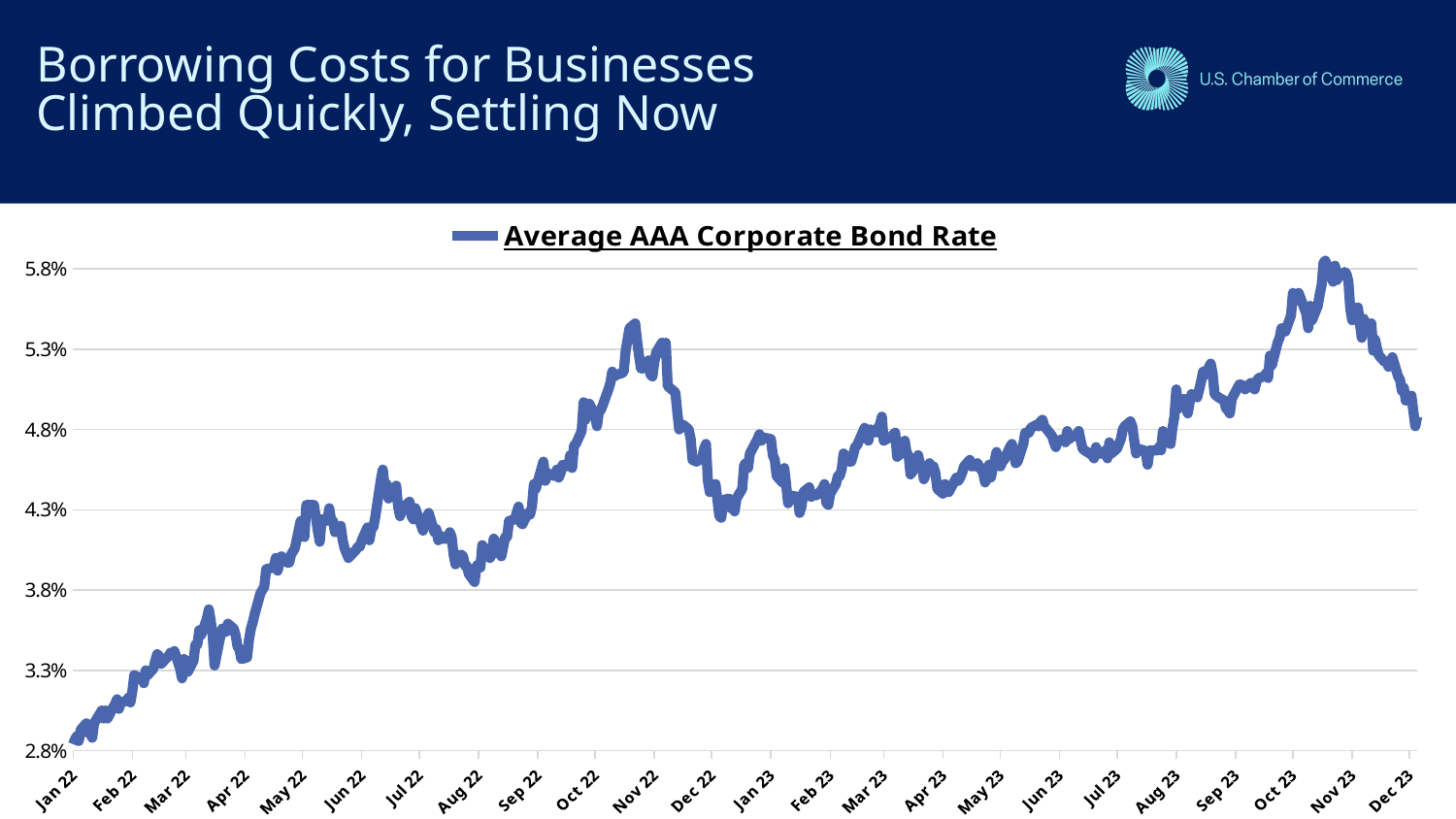
How many month labels are shown along the x axis? 24 Is the value for Sep 23 greater or less than 4.8%? greater Which is larger, the value at Jan 22 or the value at Dec 23? Dec 23 What is the name of the series shown in the legend? Average AAA Corporate Bond Rate What is the title of the slide containing the chart? Borrowing Costs for Businesses Climbed Quickly, Settling Now How many series does the legend list? 1 Overall, does the Average AAA Corporate Bond Rate rise or fall from Jan 22 to Dec 23? rise Is the value for Jan 22 greater or less than 3.3%? less Which is higher, the peak reached in late 2022 (around Nov 22) or the peak reached in late 2023 (around Oct 23)? the late 2023 peak (around Oct 23) What kind of chart is shown on the slide? line chart